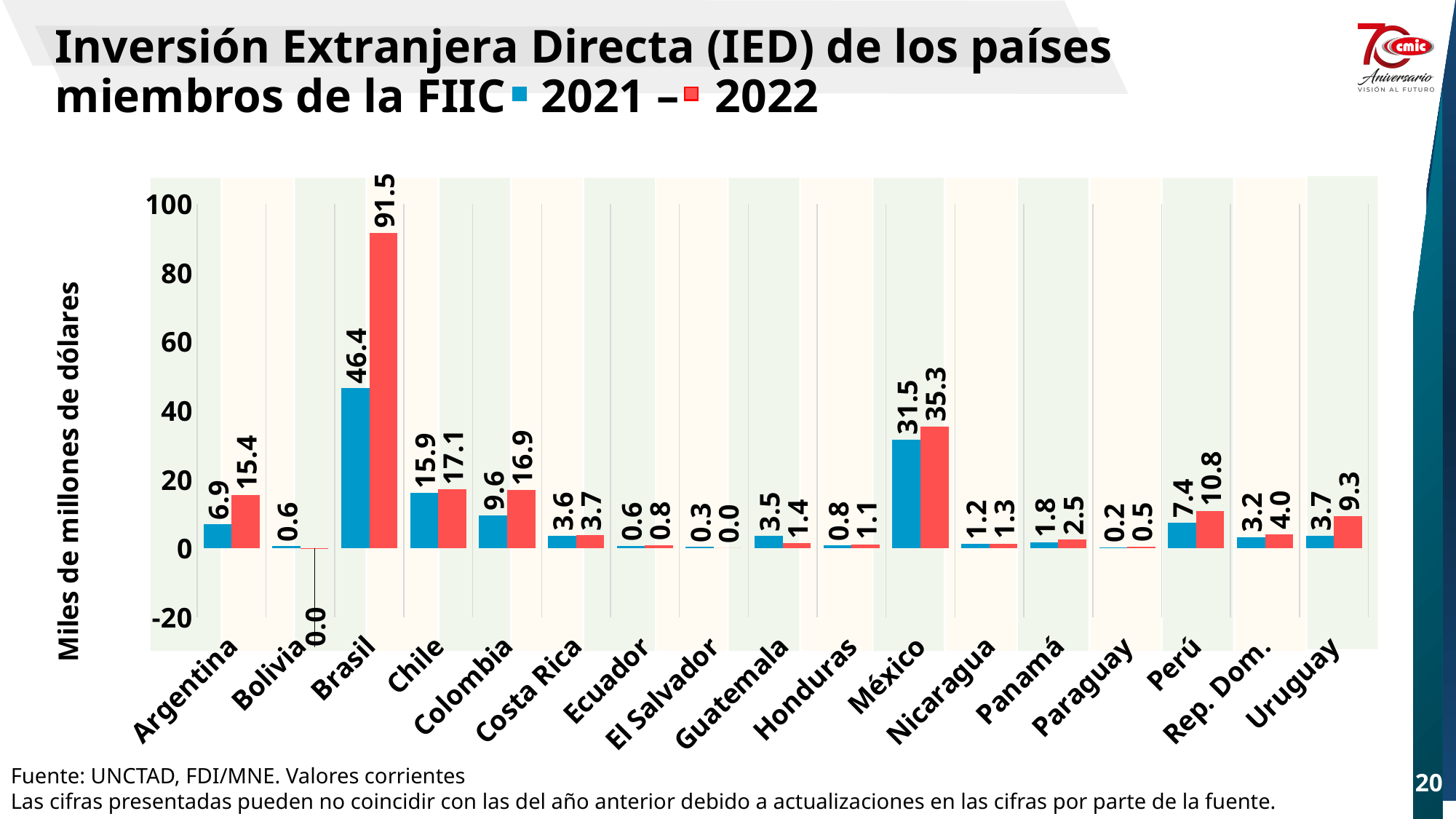
Which country has the lowest 2021 value? Paraguay How many series does the chart show? 2 What kind of chart is shown on the slide? Bar chart What is the difference between the 2022 and 2021 values for Argentina? 8.5 What is the 2022 value for Brasil? 91.5 Is the 2021 value for Brasil greater or less than 40? greater Which is larger for Guatemala, the 2021 value or the 2022 value? 2021 How many countries are shown on the x axis? 17 What is the 2022 value for Perú? 10.8 What is the 2021 value for México? 31.5 Which country has the highest 2022 value? Brasil What is the y-axis label of the chart? Miles de millones de dólares